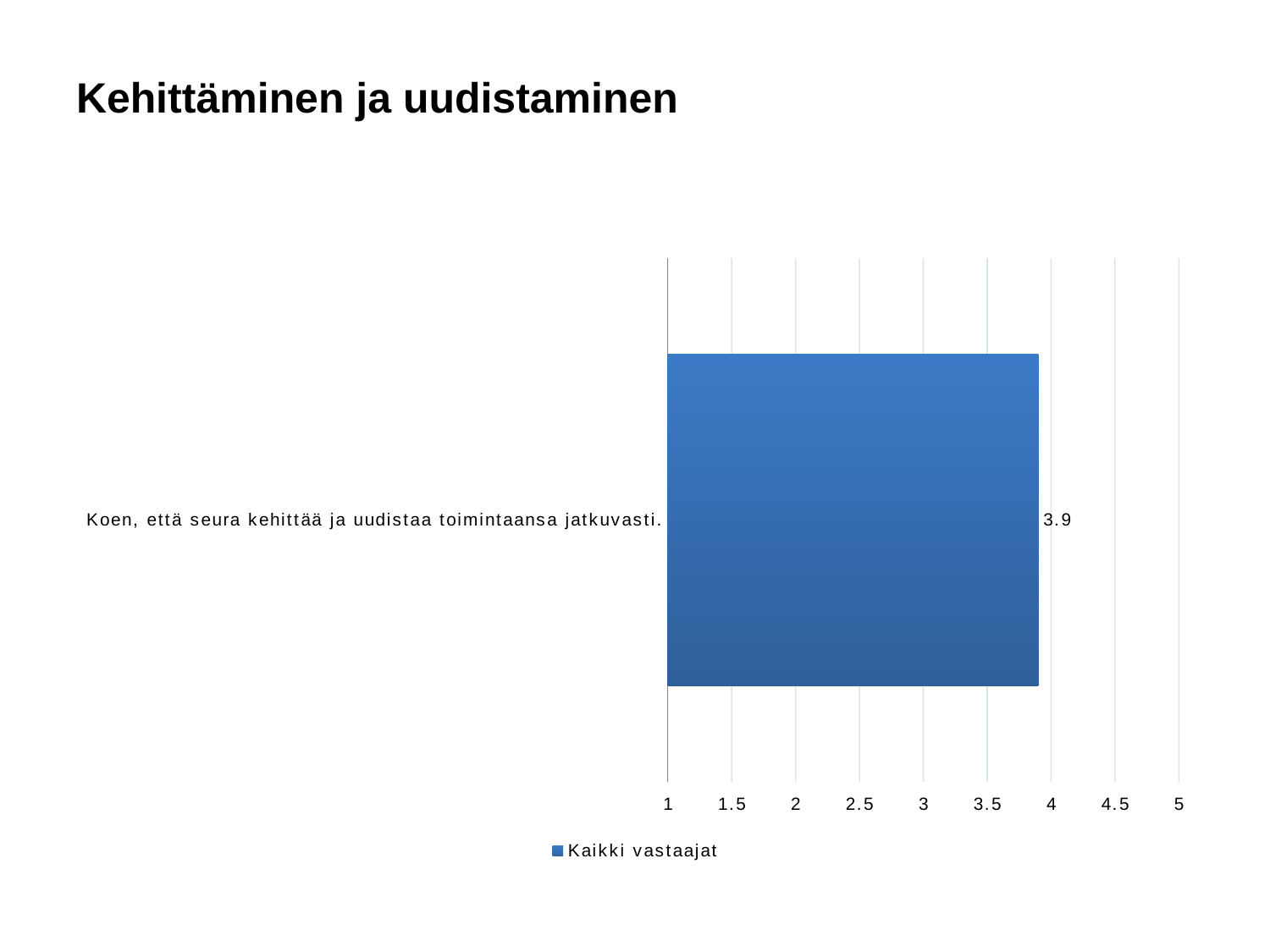
What is the value for "Koen, että seura kehittää ja uudistaa toimintaansa jatkuvasti."? 3.9 How many categories does the chart show? 1 What is the highest value shown on the x axis? 5 Is the value for "Koen, että seura kehittää ja uudistaa toimintaansa jatkuvasti." greater or less than 3.5? greater What is the title of the slide? Kehittäminen ja uudistaminen What series name is shown in the legend? Kaikki vastaajat What kind of chart is shown on the slide? bar chart Is the value for "Koen, että seura kehittää ja uudistaa toimintaansa jatkuvasti." greater or less than 4? less How many series does the legend list? 1